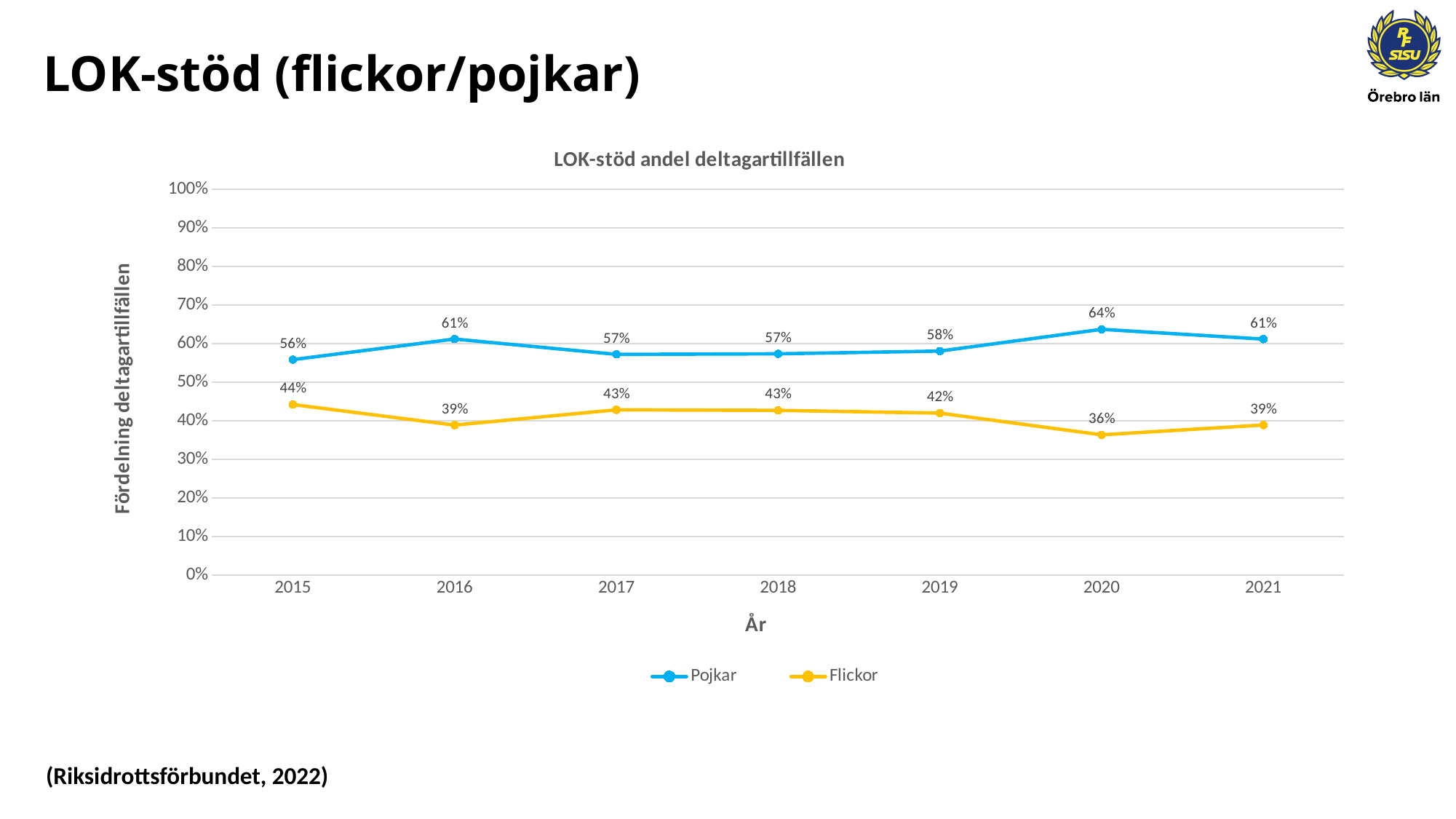
How many series does the legend list? 2 How many years are shown on the x axis? 7 What kind of chart is shown on the slide? Line chart What is the value for Flickor in 2020? 36% What is the difference between the Pojkar and Flickor values in 2021? 22% Which series has the larger value in 2018, Pojkar or Flickor? Pojkar Does the Flickor value rise or fall from 2015 to 2016? Fall What is the title of the chart? LOK-stöd andel deltagartillfällen In which year is the Flickor value lowest? 2020 What is the value for Pojkar in 2020? 64% What is the value for Flickor in 2015? 44% In which year is the Pojkar value highest? 2020